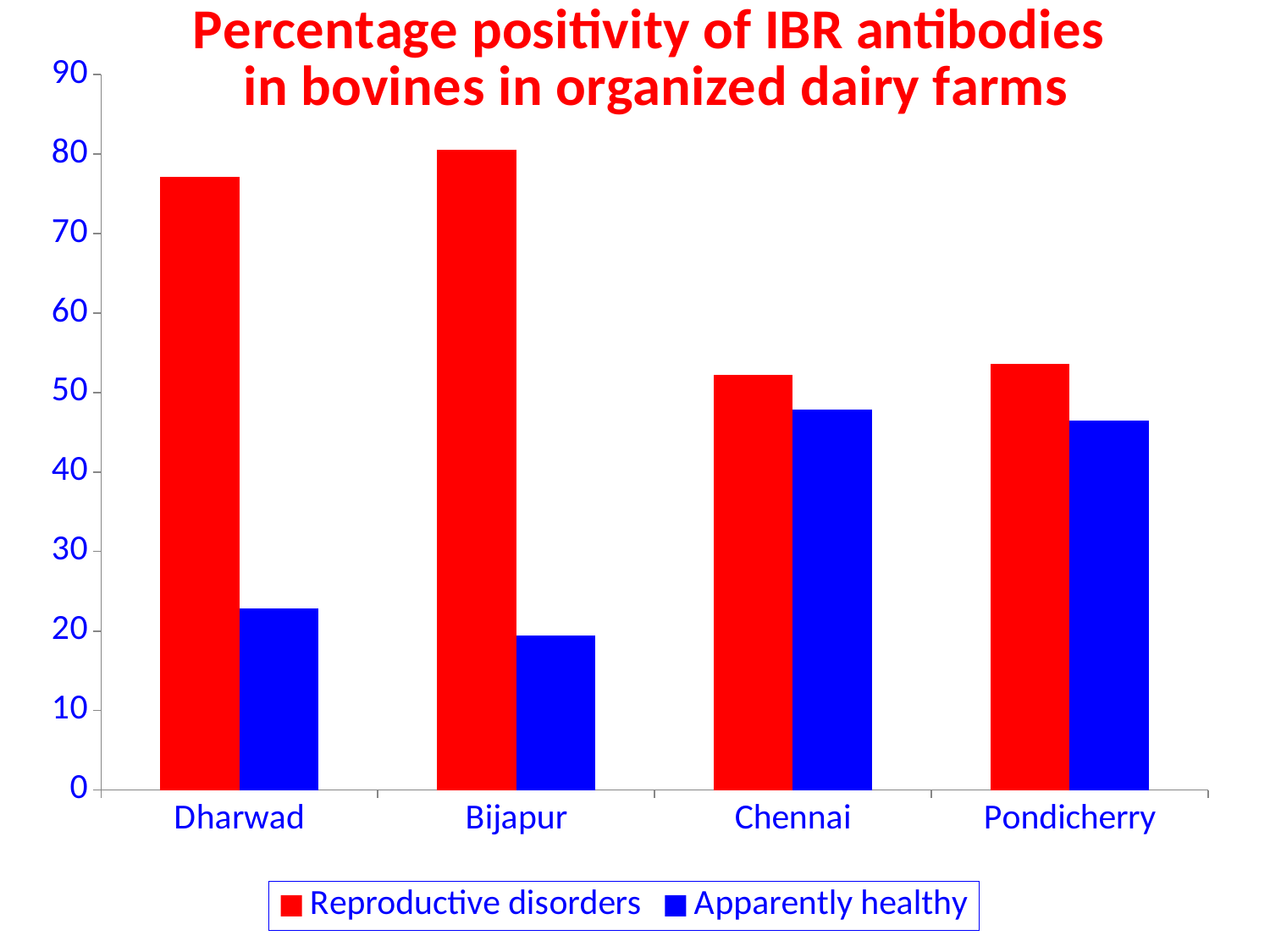
Which is larger: Apparently healthy in Dharwad or Apparently healthy in Chennai? Chennai Which location has the highest value for Reproductive disorders? Bijapur What type of chart is shown on the slide? bar chart What colour represents the Apparently healthy series? blue Which location has the lowest value for Apparently healthy? Bijapur Which is larger in Pondicherry: Reproductive disorders or Apparently healthy? Reproductive disorders How many series does the legend list? 2 How many categories (locations) are shown on the x axis? 4 Is the value for Reproductive disorders in Dharwad greater or less than 70? greater Is the value for Apparently healthy in Dharwad greater or less than 20? greater Is the value for Apparently healthy in Chennai greater or less than 50? less